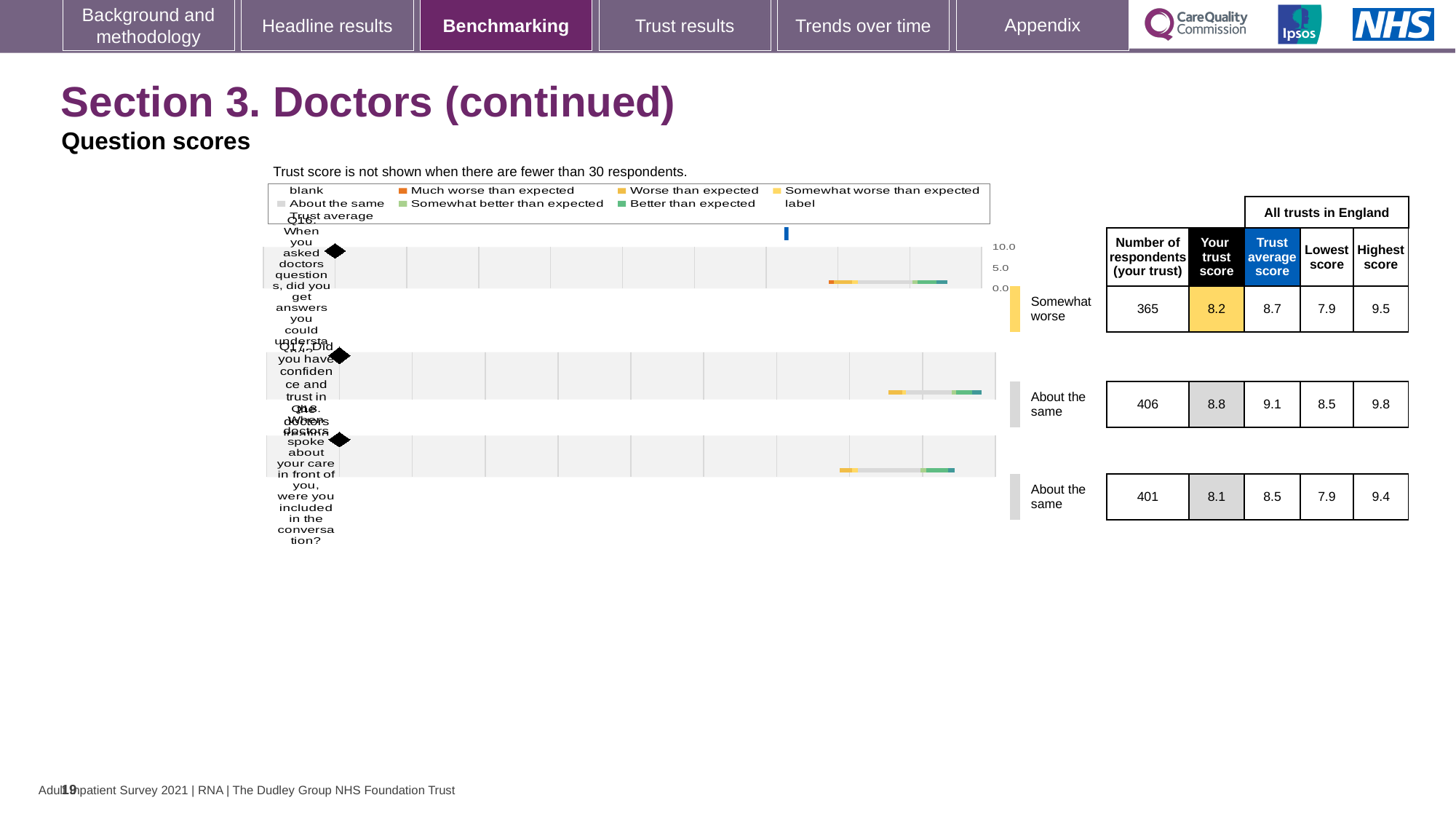
What benchmark category is shown for Q16? Somewhat worse Which question has the highest 'Your trust score'? Q17 What is the trust average score for Q17 (Did you have confidence and trust in the doctors treating you?)? 9.1 For Q17, what is the difference between the highest score and the lowest score across all trusts in England? 1.3 What is the highest score across all trusts in England for Q16? 9.5 Which question has the lowest 'Your trust score'? Q18 For Q16, how much higher is the trust average score than your trust score? 0.5 How many questions are shown in the chart? 3 What is the lowest score across all trusts in England for Q17? 8.5 For Q18, which is larger: your trust score or the trust average score? Trust average score How many respondents from your trust answered Q18 (When doctors spoke about your care in front of you, were you included in the conversation?)? 401 What is the 'Your trust score' for Q16 (When you asked doctors questions, did you get answers you could understand?)? 8.2